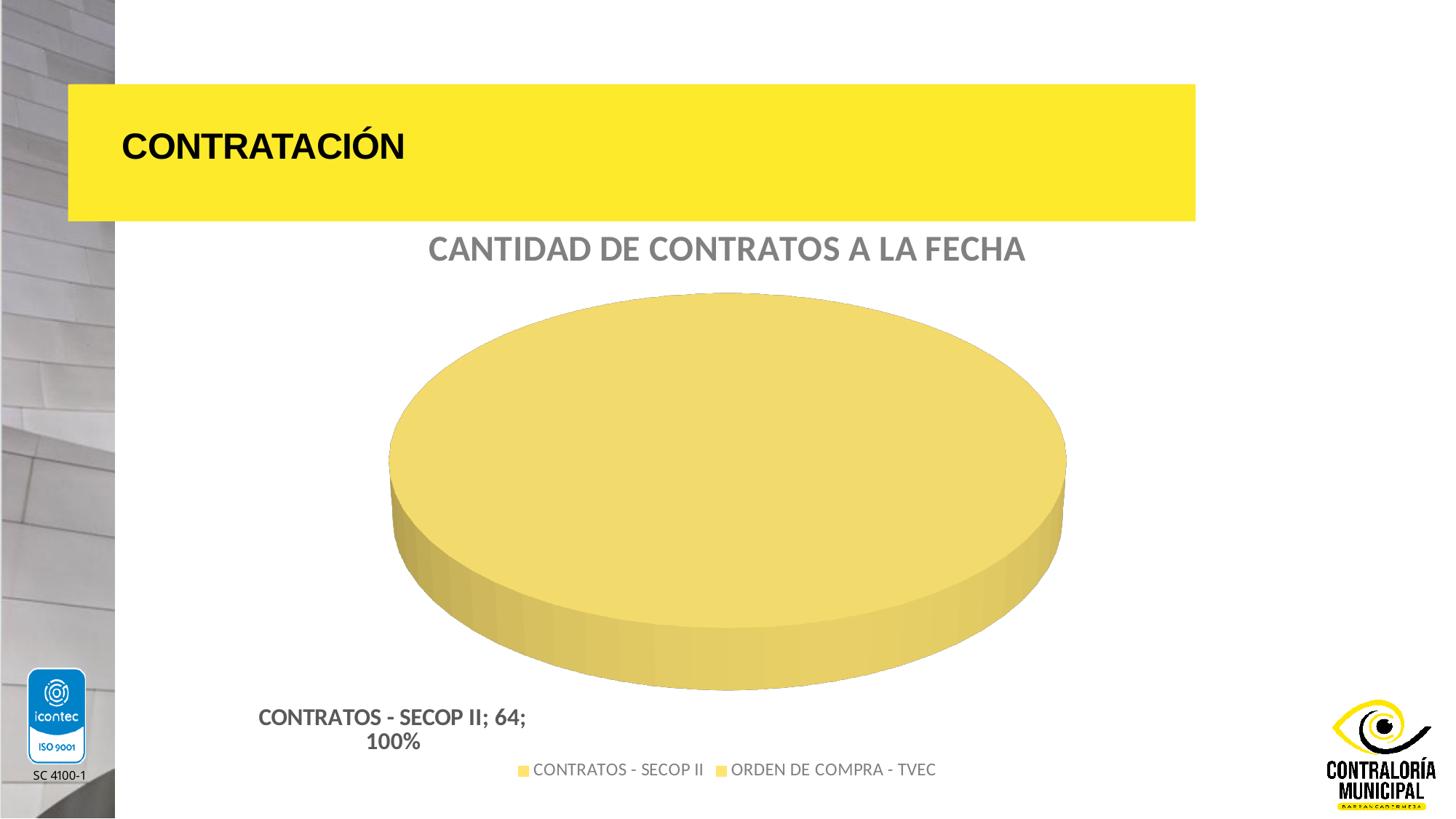
What share of the pie does CONTRATOS - SECOP II represent? 100% What is the value shown for CONTRATOS - SECOP II? 64 Which category makes up the entire pie? CONTRATOS - SECOP II Is the value for CONTRATOS - SECOP II greater or less than 50? greater What is the title of the chart? CANTIDAD DE CONTRATOS A LA FECHA What kind of chart is shown on the slide? pie chart Which is larger, the share for CONTRATOS - SECOP II or for ORDEN DE COMPRA - TVEC? CONTRATOS - SECOP II Which legend entry has no visible slice in the pie? ORDEN DE COMPRA - TVEC How many entries does the legend list? 2 What are the two legend entries of the chart? CONTRATOS - SECOP II and ORDEN DE COMPRA - TVEC